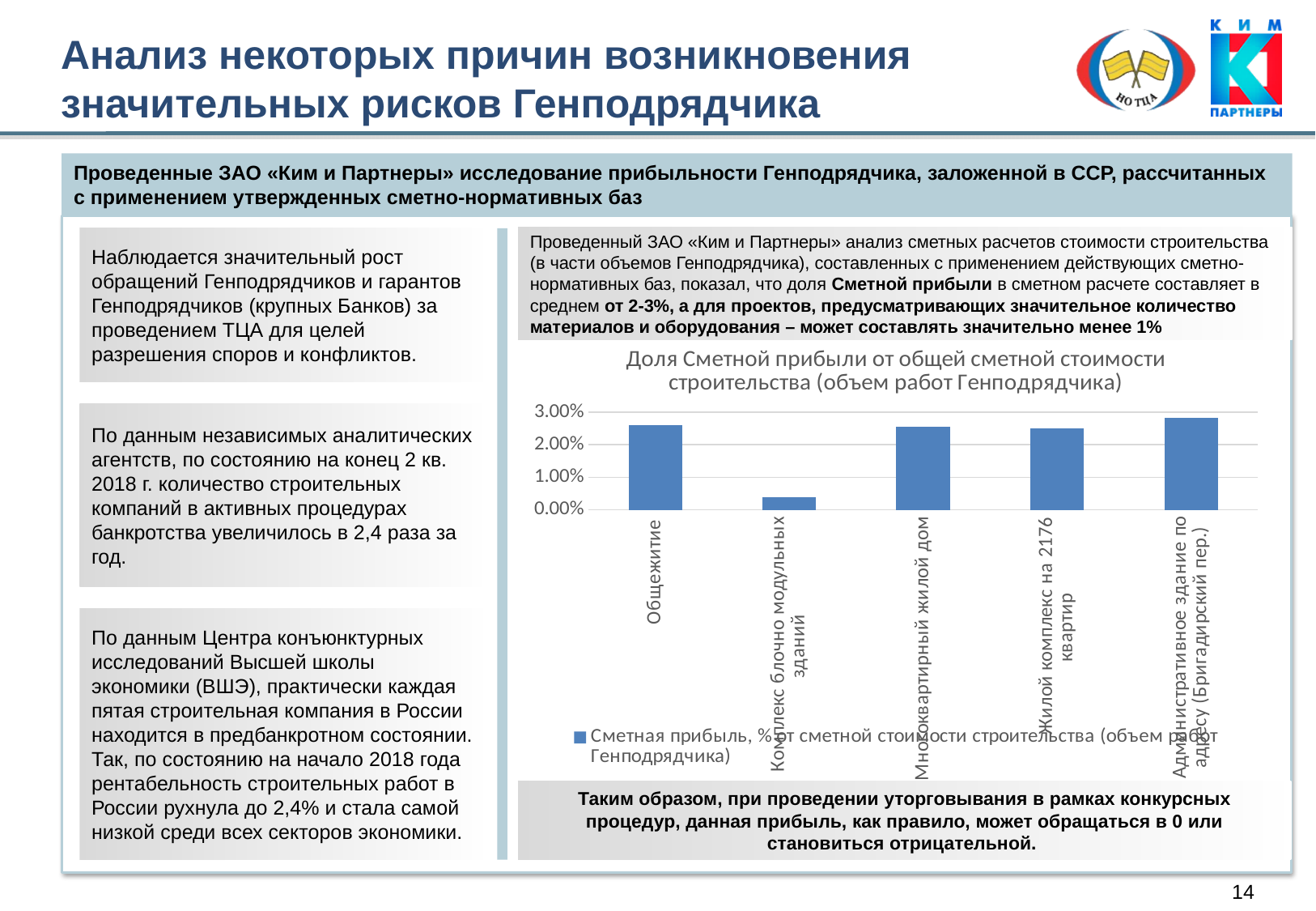
Is the value for Общежитие greater or less than 2.00%? greater Is the value for Административное здание по адресу (Бригадирский пер.) greater or less than 3.00%? less What kind of chart is shown on the slide? Bar chart Is the value for Жилой комплекс на 2176 квартир greater or less than 2.00%? greater What is the name of the series shown in the chart legend? Сметная прибыль, % от сметной стоимости строительства (объем работ Генподрядчика) Which category has the lowest share of estimated profit in the chart? Комплекс блочно модульных зданий Which has the larger value: Общежитие or Комплекс блочно модульных зданий? Общежитие How many categories (building types) are plotted in the chart? 5 How many series does the chart legend list? 1 Which category has the highest share of estimated profit in the chart? Административное здание по адресу (Бригадирский пер.) What is the title of the chart? Доля Сметной прибыли от общей сметной стоимости строительства (объем работ Генподрядчика)